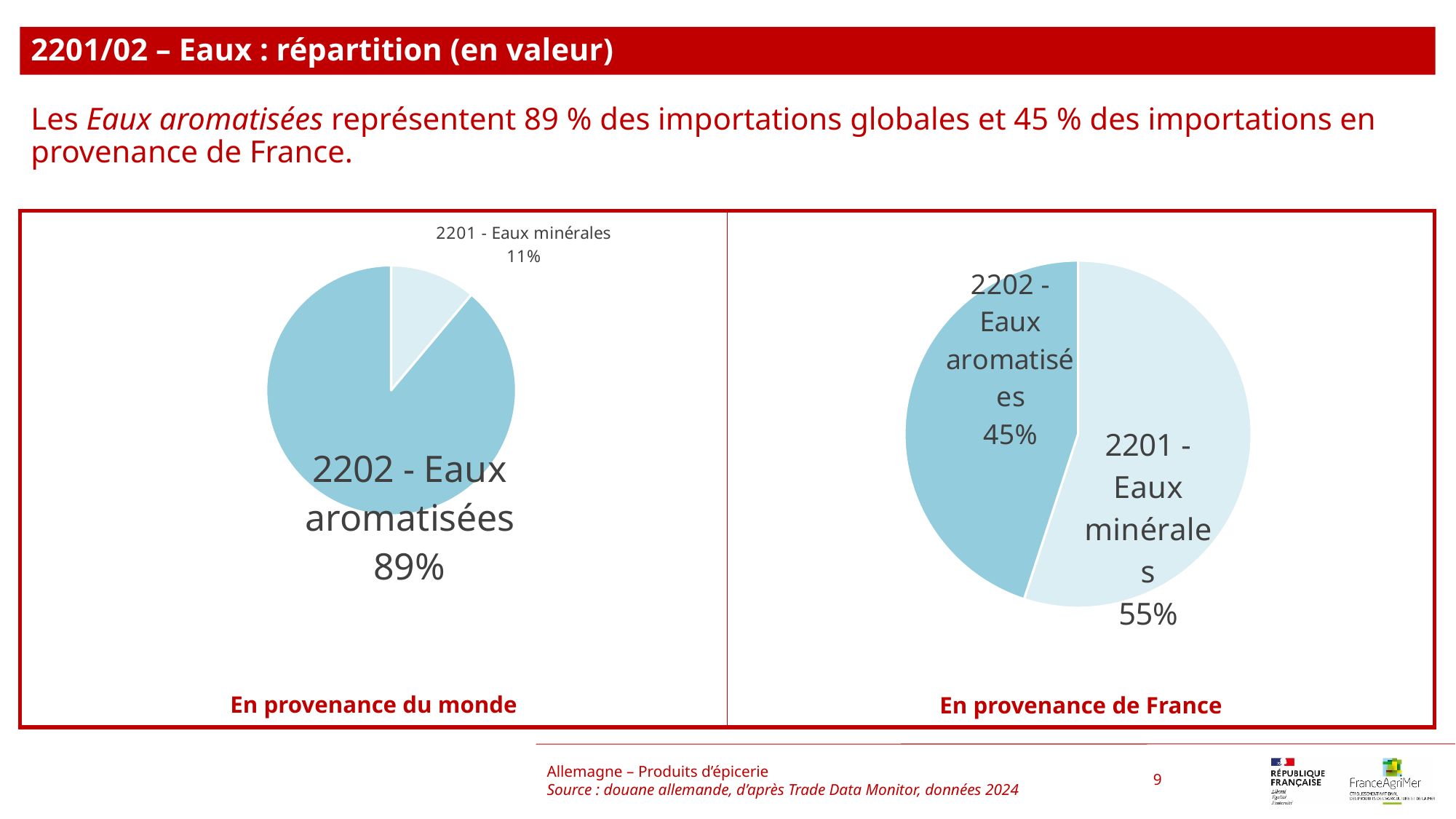
How many categories does the 'En provenance de France' chart show? 2 How many charts are shown on the slide? 2 In the 'En provenance de France' chart, what share does '2202 - Eaux aromatisées' have? 45% In the 'En provenance du monde' chart, which category has the largest slice? 2202 - Eaux aromatisées What kind of chart is the 'En provenance du monde' chart? Pie chart In the 'En provenance de France' chart, which category has the smallest slice? 2202 - Eaux aromatisées In the 'En provenance de France' chart, what share does '2201 - Eaux minérales' have? 55% In the 'En provenance de France' chart, what is the difference in percentage points between '2201 - Eaux minérales' and '2202 - Eaux aromatisées'? 10 percentage points In the 'En provenance de France' chart, which is larger: '2201 - Eaux minérales' or '2202 - Eaux aromatisées'? 2201 - Eaux minérales In the 'En provenance du monde' chart, what share does '2201 - Eaux minérales' have? 11% In the 'En provenance du monde' chart, what is the difference in percentage points between '2202 - Eaux aromatisées' and '2201 - Eaux minérales'? 78 percentage points